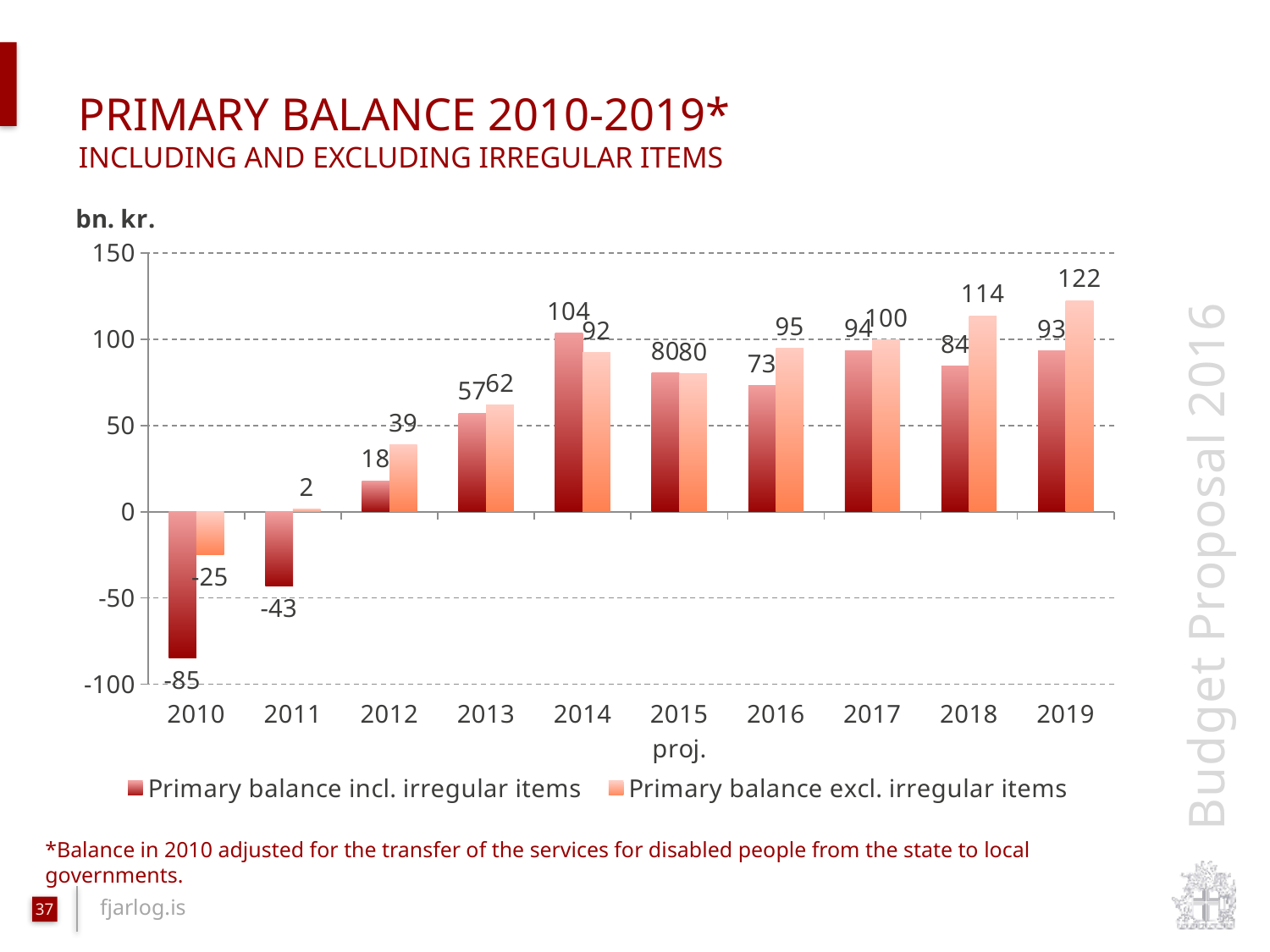
What is the value of Primary balance excl. irregular items for 2011? 2 What is the difference between Primary balance excl. irregular items and Primary balance incl. irregular items in 2018? 30 How many years are shown on the x axis? 10 Which year has the lowest value for Primary balance excl. irregular items? 2010 What kind of chart is shown on the slide? Bar chart How many series does the legend list? 2 Which year has the highest value for Primary balance incl. irregular items? 2014 What unit is shown above the y axis of the chart? bn. kr. In 2014, which series has the larger value: Primary balance incl. irregular items or Primary balance excl. irregular items? Primary balance incl. irregular items What is the value of Primary balance excl. irregular items for 2019? 122 What is the value of Primary balance incl. irregular items for 2010? -85 Does Primary balance excl. irregular items generally rise or fall from 2010 to 2019? Rise